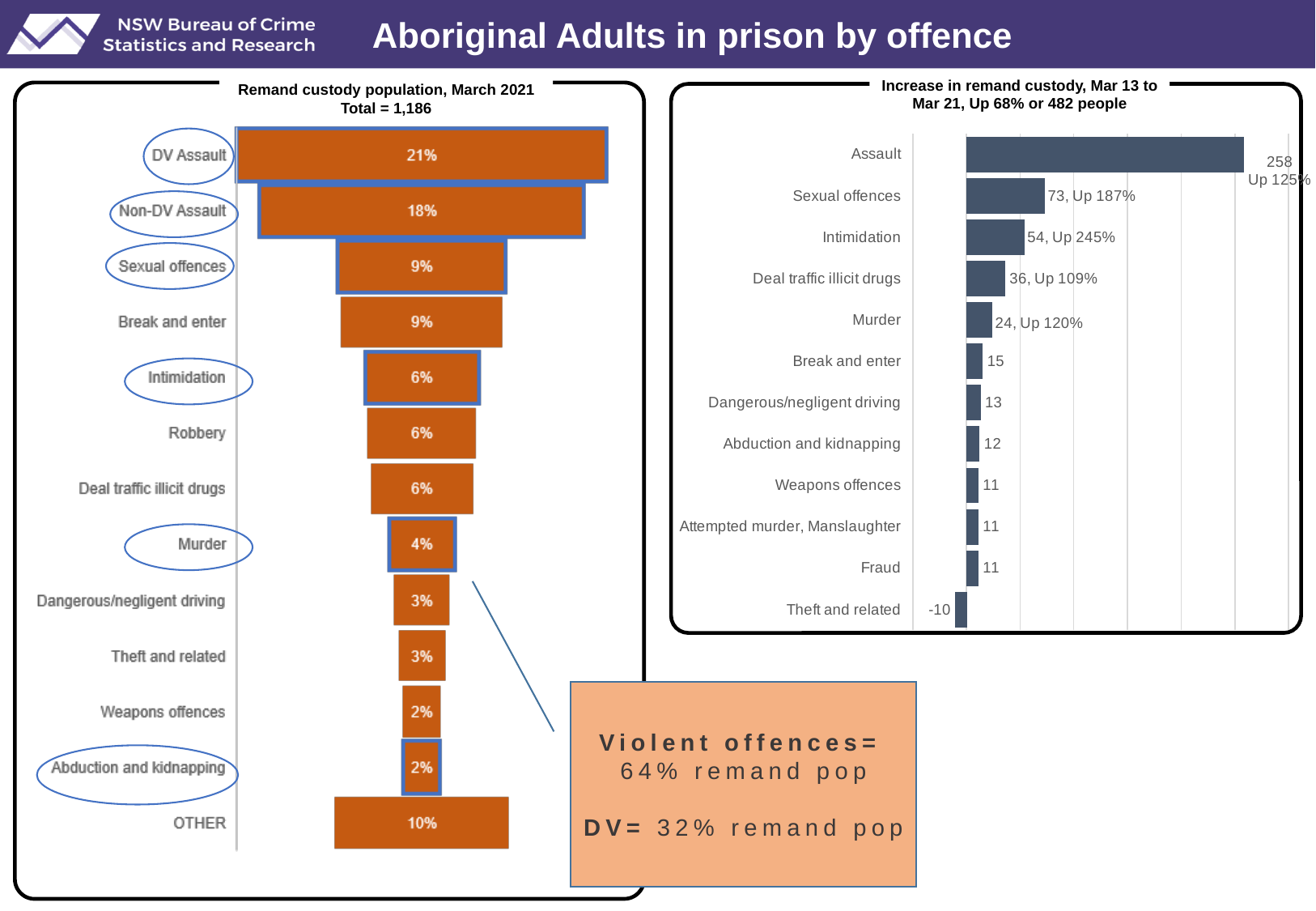
In the 'Increase in remand custody, Mar 13 to Mar 21' chart, what is the value for Intimidation? 54 In the 'Increase in remand custody, Mar 13 to Mar 21' chart, what is the value for Assault? 258 In the 'Increase in remand custody, Mar 13 to Mar 21' chart, which is larger, the value for Deal traffic illicit drugs or the value for Break and enter? Deal traffic illicit drugs In the 'Remand custody population, March 2021' chart, which category has the highest percentage? DV Assault In the 'Increase in remand custody, Mar 13 to Mar 21' chart, which category has the lowest value? Theft and related In the 'Remand custody population, March 2021' chart, what percentage is shown for DV Assault? 21% In the 'Remand custody population, March 2021' chart, what is the total remand custody population stated in the title? 1,186 In the 'Remand custody population, March 2021' chart, what percentage is shown for Sexual offences? 9% In the 'Remand custody population, March 2021' chart, what is the difference in percentage points between DV Assault and Non-DV Assault? 3 What type of chart is the 'Increase in remand custody, Mar 13 to Mar 21' chart? Bar chart How many categories are shown in the 'Increase in remand custody, Mar 13 to Mar 21' chart? 12 In the 'Increase in remand custody, Mar 13 to Mar 21' chart, what is the difference between the values for Sexual offences and Murder? 49